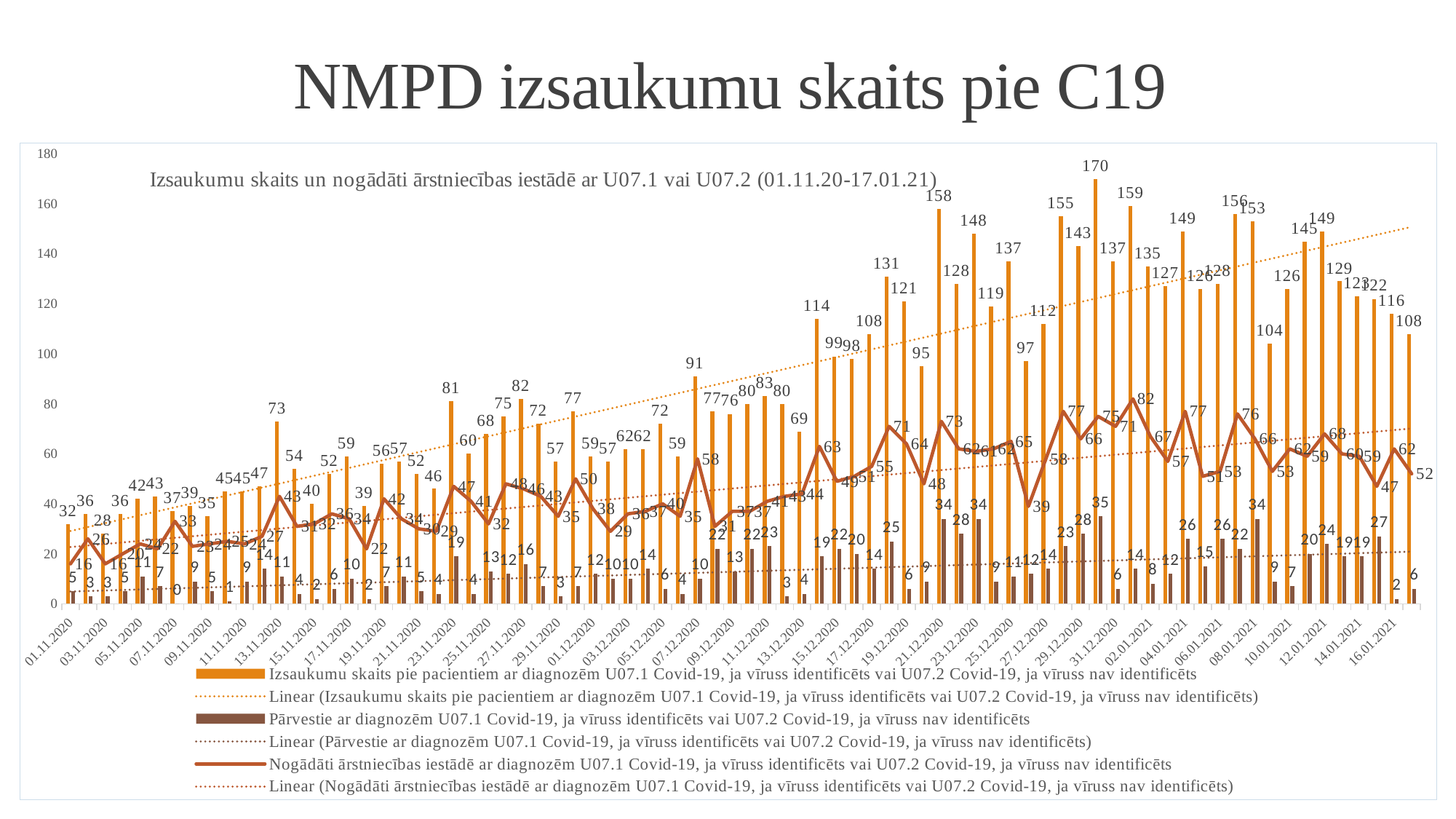
Overall, do the orange bars (Izsaukumu skaits) rise or fall from left to right along the x axis? rise Is the orange bar value on 01.11.2020 greater or less than 40? less What is the highest value labelled on the Nogādāti ārstniecības iestādē line? 82 What is the value of the Nogādāti ārstniecības iestādē line on 01.11.2020? 16 What is the title printed inside the chart area? Izsaukumu skaits un nogādāti ārstniecības iestādē ar U07.1 vai U07.2 (01.11.20-17.01.21) What is the value of the orange bar (Izsaukumu skaits) on 01.11.2020? 32 What kind of chart is shown on the slide? A combined bar and line chart How many entries does the chart legend list? 6 What is the value of the rightmost orange bar (Izsaukumu skaits)? 108 What is the lowest value labelled on the orange bars (Izsaukumu skaits)? 28 What is the highest value labelled on the orange bars (Izsaukumu skaits)? 170 What is the difference between the highest orange bar value (170) and the orange bar value on 01.11.2020 (32)? 138